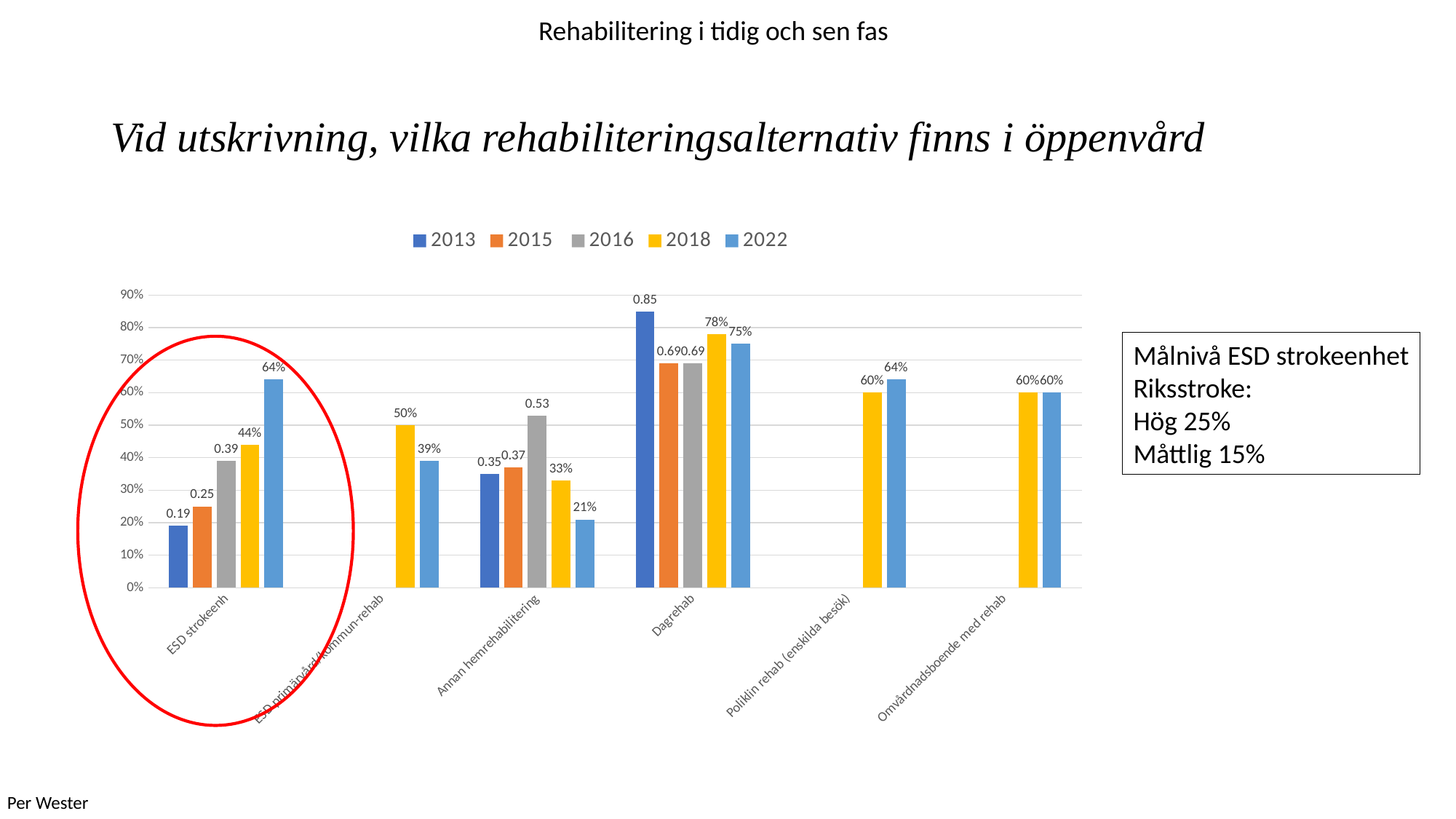
What is the value for Poliklin rehab (enskilda besök) in 2018? 60% How many series does the legend list? 5 What type of chart is shown on the slide? bar chart Do the values for ESD strokeenh rise or fall from 2013 to 2022? rise What is the value for Dagrehab in 2013? 0.85 Which is larger for Dagrehab: the 2018 value or the 2022 value? 2018 What is the value for Annan hemrehabilitering in 2016? 0.53 What is the difference between the 2022 and 2018 values for ESD strokeenh? 20% Which category has the highest value in 2013? Dagrehab What is the value for ESD strokeenh in 2022? 64% Which year is shown in yellow in the legend? 2018 Which category has the lowest value in 2022? Annan hemrehabilitering